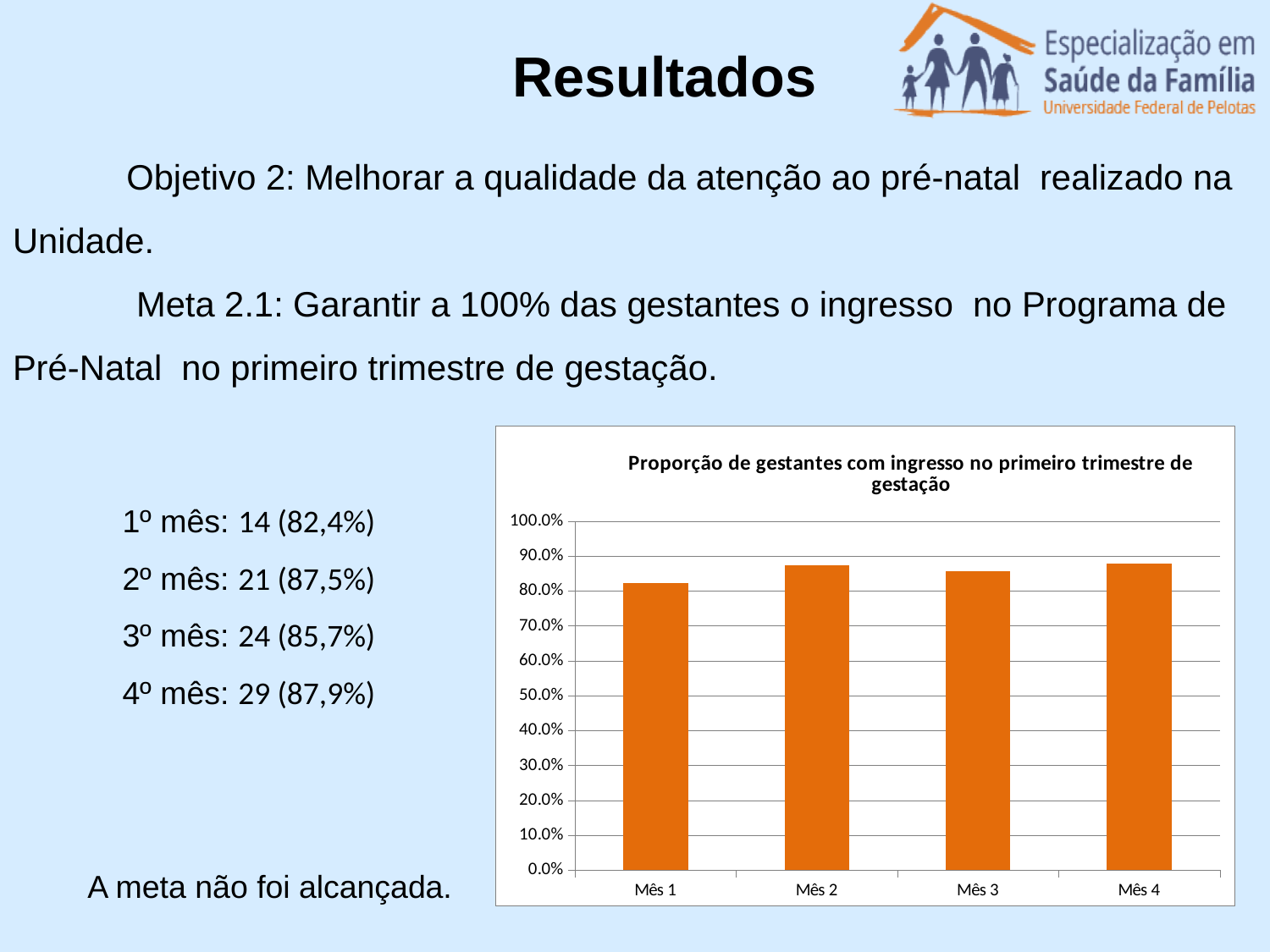
What colour are the bars in the chart? orange What kind of chart is shown on the slide? bar chart What is the title of the chart? Proporção de gestantes com ingresso no primeiro trimestre de gestação Which is larger, the value for Mês 1 or the value for Mês 2? Mês 2 Which month has the lowest bar in the chart? Mês 1 What is the highest value shown on the vertical axis of the chart? 100.0% How many categories (months) are plotted on the chart? 4 Is the value for Mês 3 greater or less than 80.0%? greater Is the value for Mês 4 greater or less than 70.0%? greater Is the value for Mês 2 greater or less than 90.0%? less Which is larger, the value for Mês 1 or the value for Mês 4? Mês 4